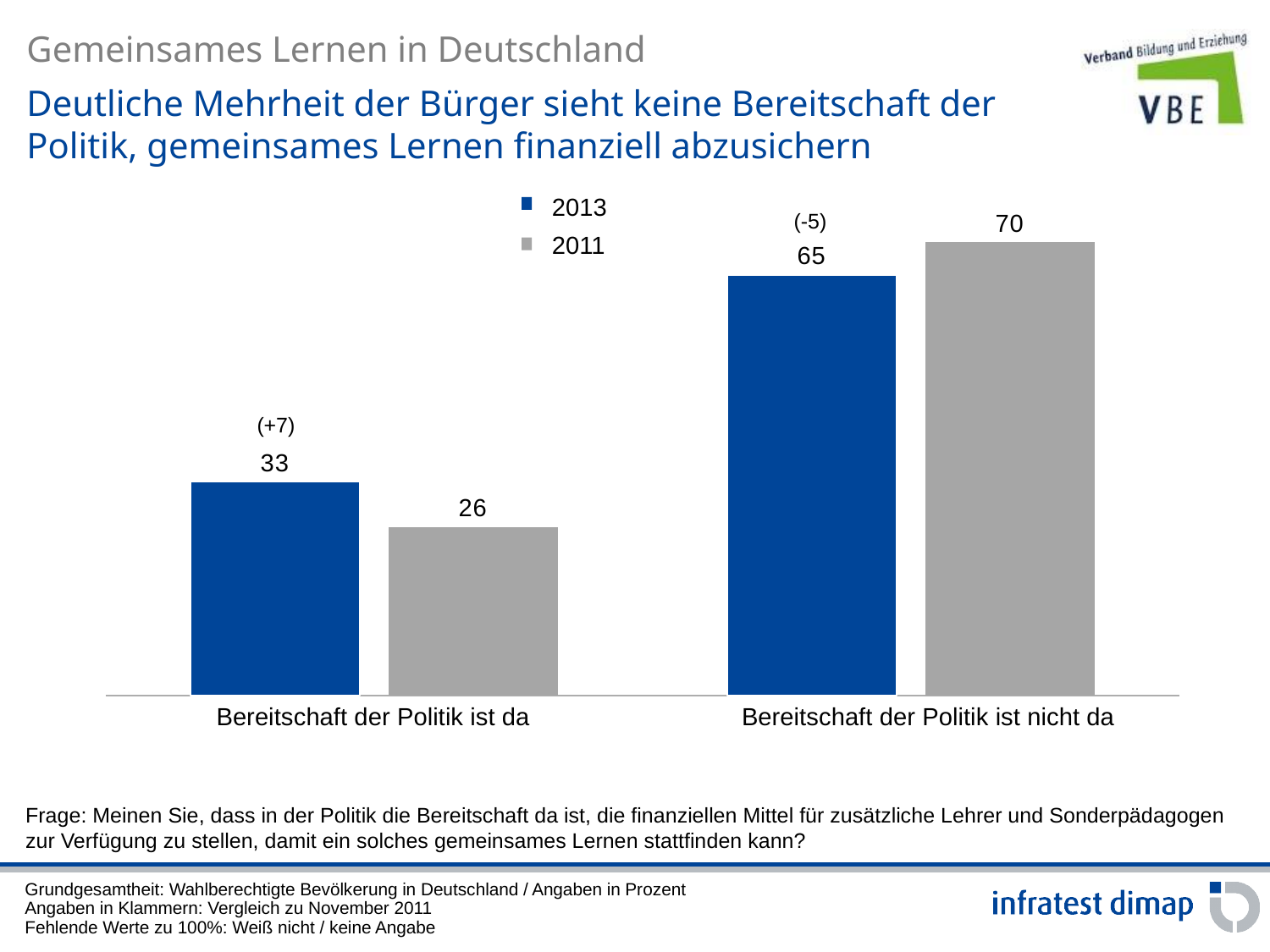
What is the difference between the 2013 and 2011 values for "Bereitschaft der Politik ist da"? 7 Which category has the highest 2013 value? Bereitschaft der Politik ist nicht da What is the 2013 value for "Bereitschaft der Politik ist nicht da"? 65 How many series does the legend list? 2 How many categories are shown on the x axis? 2 What is the difference between the 2011 and 2013 values for "Bereitschaft der Politik ist nicht da"? 5 What is the 2013 value for "Bereitschaft der Politik ist da"? 33 Which is larger for "Bereitschaft der Politik ist nicht da": the 2013 value or the 2011 value? 2011 What is the 2011 value for "Bereitschaft der Politik ist nicht da"? 70 Which category has the lowest 2011 value? Bereitschaft der Politik ist da What is the 2011 value for "Bereitschaft der Politik ist da"? 26 What kind of chart is shown on the slide? Bar chart